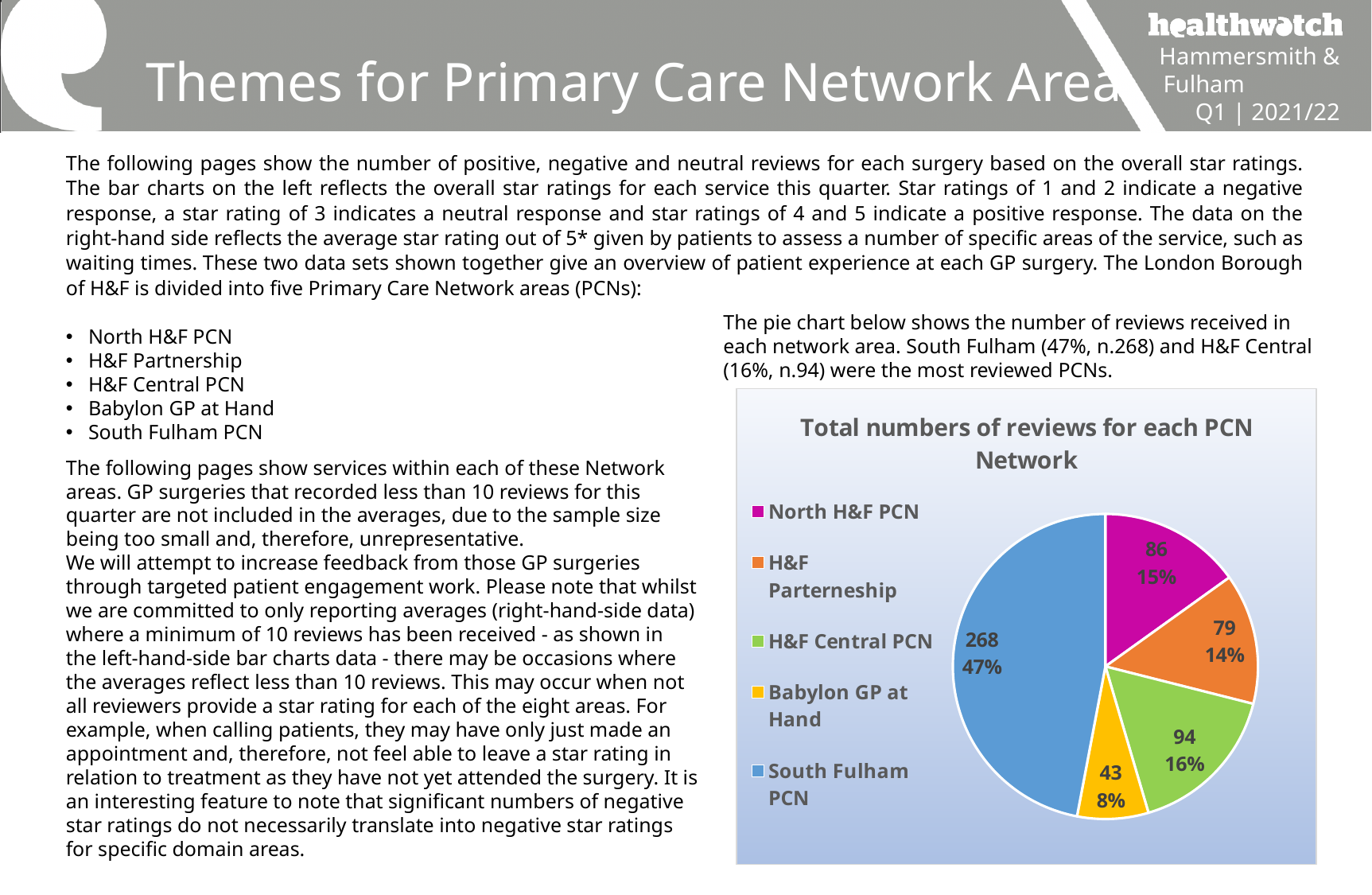
How many reviews were received for Babylon GP at Hand? 43 What type of chart is shown on the slide? pie chart How many reviews were received for North H&F PCN? 86 Which has more reviews, North H&F PCN or H&F Parterneship? North H&F PCN What share of the pie does H&F Parterneship represent? 14% Which PCN has the lowest number of reviews? Babylon GP at Hand How many reviews were received for South Fulham PCN? 268 What is the difference in reviews between South Fulham PCN and H&F Central PCN? 174 What share of the pie does H&F Central PCN represent? 16% What is the title of the chart? Total numbers of reviews for each PCN Network Which PCN has the highest number of reviews? South Fulham PCN How many PCN categories does the pie chart show? 5